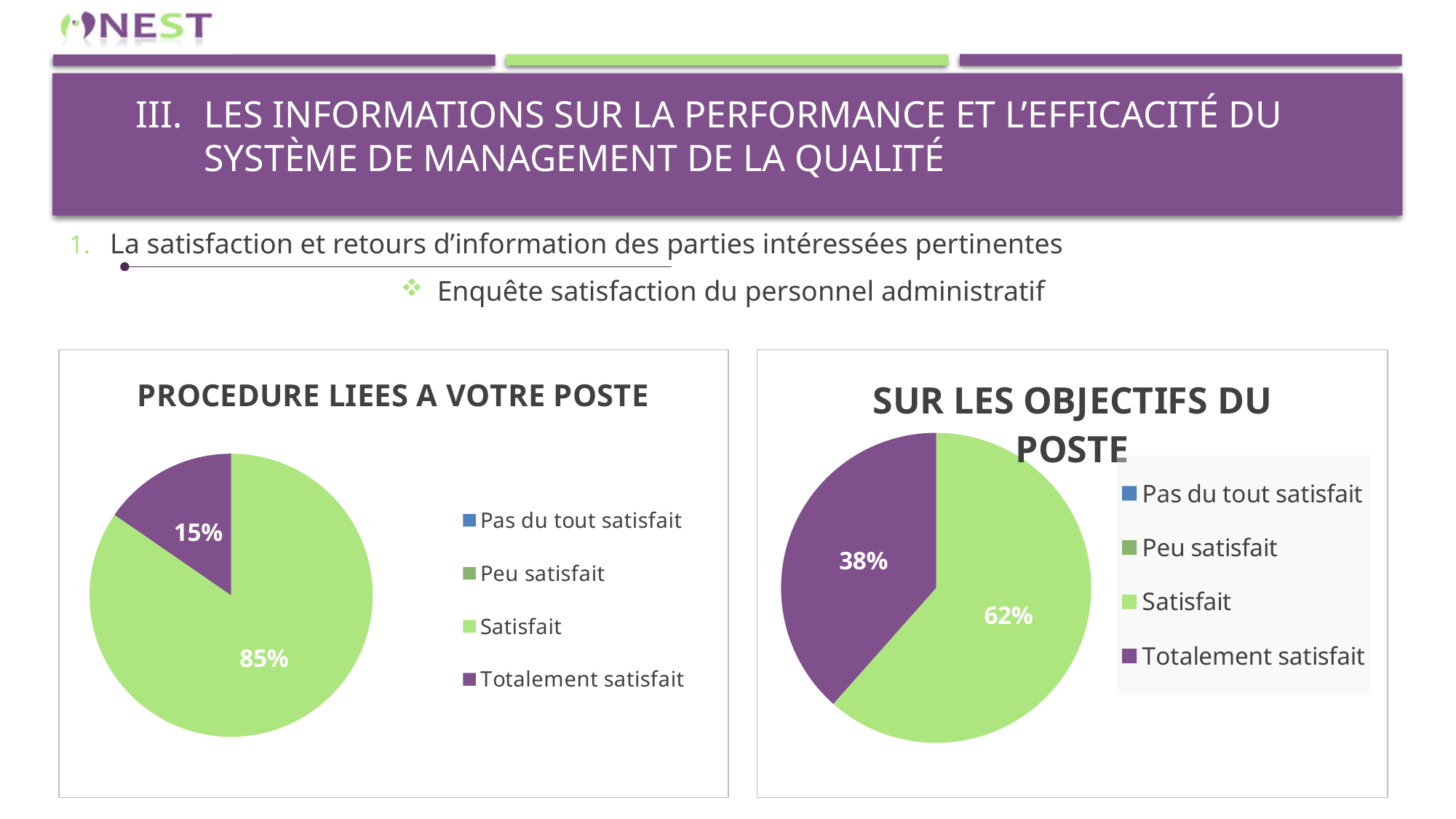
In the chart titled "SUR LES OBJECTIFS DU POSTE", what colour is the "Satisfait" slice? Green Which chart has the larger "Totalement satisfait" share, "PROCEDURE LIEES A VOTRE POSTE" or "SUR LES OBJECTIFS DU POSTE"? SUR LES OBJECTIFS DU POSTE In the chart titled "SUR LES OBJECTIFS DU POSTE", which category has the smallest visible slice? Totalement satisfait In the chart titled "PROCEDURE LIEES A VOTRE POSTE", what share of the pie is "Satisfait"? 85% In the chart titled "SUR LES OBJECTIFS DU POSTE", what is the difference in percentage points between "Satisfait" and "Totalement satisfait"? 24 In the chart titled "PROCEDURE LIEES A VOTRE POSTE", which category has the largest slice? Satisfait In the chart titled "SUR LES OBJECTIFS DU POSTE", what share of the pie is "Satisfait"? 62% In the chart titled "SUR LES OBJECTIFS DU POSTE", what share of the pie is "Totalement satisfait"? 38% How many entries does the legend of the chart titled "PROCEDURE LIEES A VOTRE POSTE" list? 4 In the chart titled "PROCEDURE LIEES A VOTRE POSTE", what is the difference in percentage points between "Satisfait" and "Totalement satisfait"? 70 What type of chart is the chart titled "SUR LES OBJECTIFS DU POSTE"? Pie chart